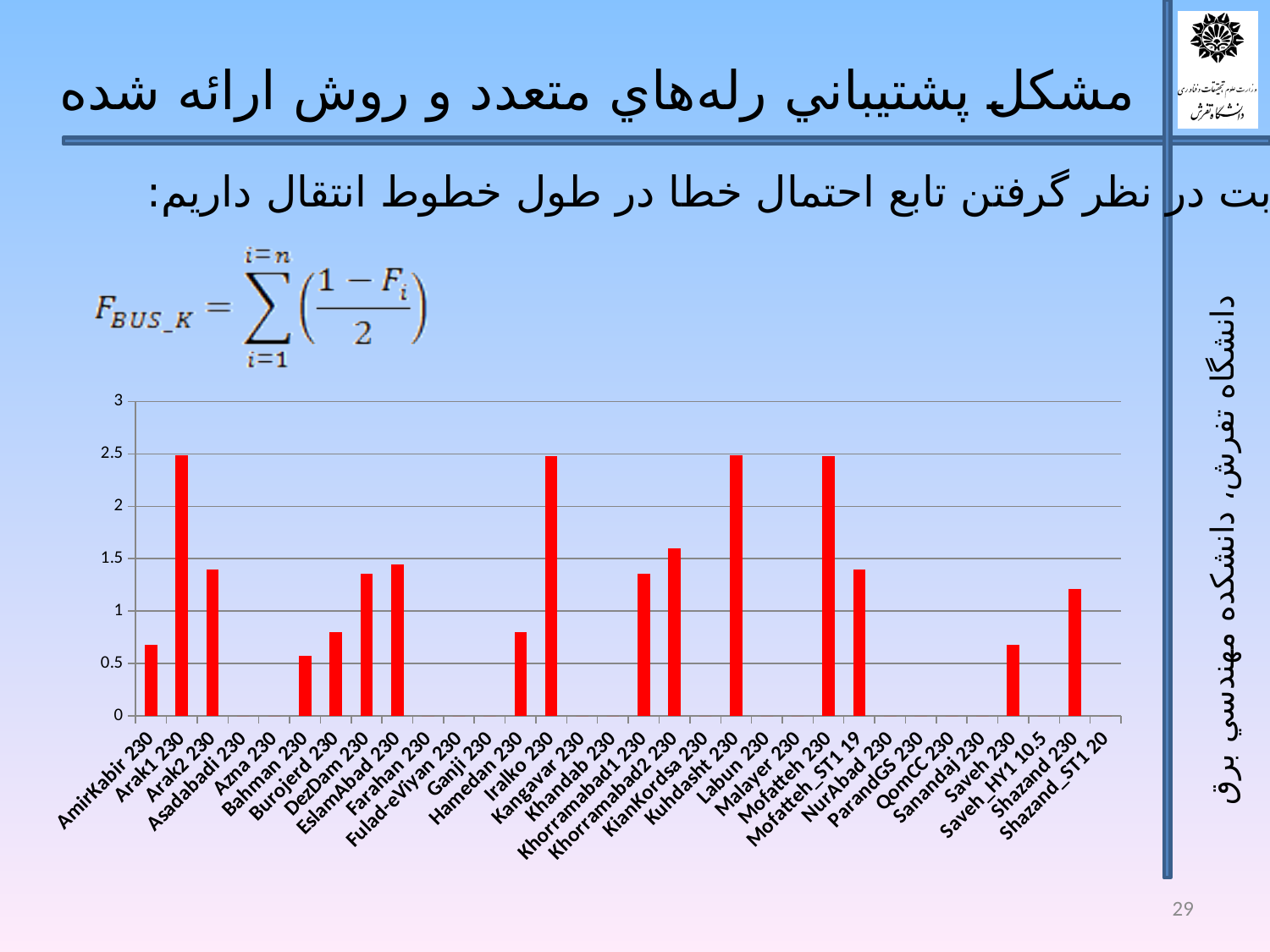
How many categories are listed along the x axis of the chart? 32 What kind of chart is shown on the slide? bar chart Is the value for Shazand 230 greater or less than 1? greater Is the value for Arak1 230 greater or less than 2? greater Is the value for Bahman 230 greater or less than 1? less Which is larger, the value for Arak1 230 or Arak2 230? Arak1 230 Which is larger, the value for Khorramabad1 230 or Khorramabad2 230? Khorramabad2 230 Which is larger, the value for Hamedan 230 or Iralko 230? Iralko 230 What colour are the bars in the chart? red